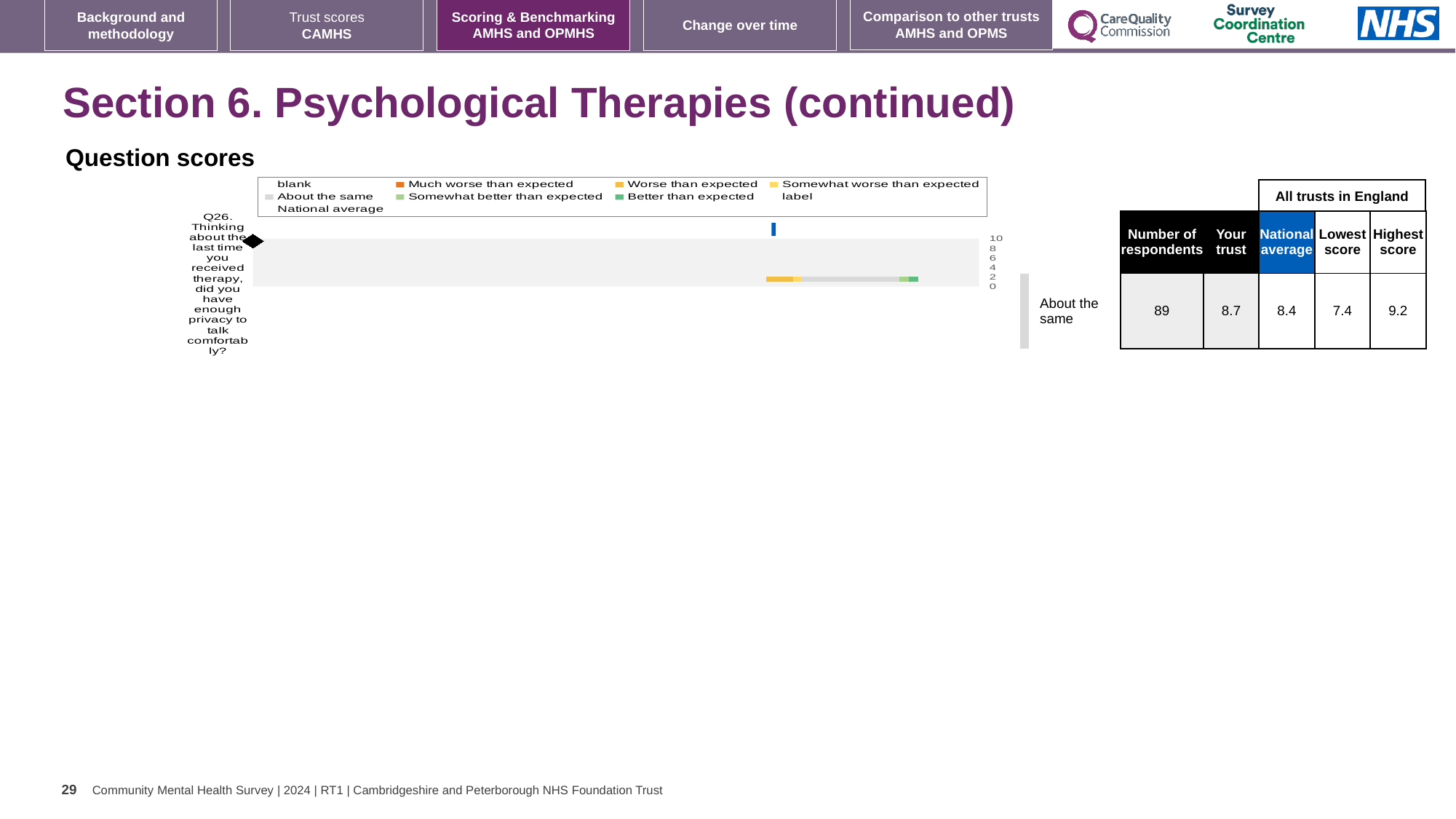
According to the label beside the chart, how does the trust's score for Q26 compare with what was expected? About the same In the table next to the chart, what is the highest score among all trusts in England for Q26? 9.2 Is the trust's score for Q26 larger or smaller than the national average? larger What is the difference between the highest score and the lowest score for Q26 in the table? 1.8 Which question number is plotted in the chart? Q26 In the table next to the chart, what is the lowest score among all trusts in England for Q26? 7.4 In the table next to the chart, what is the 'Your trust' score for Q26? 8.7 What is the highest value shown on the chart's axis? 10 How many survey questions are plotted in the chart? 1 In the table next to the chart, what is the national average score for Q26? 8.4 What kind of chart is shown under 'Question scores'? bar chart In the table next to the chart, how many respondents answered Q26? 89